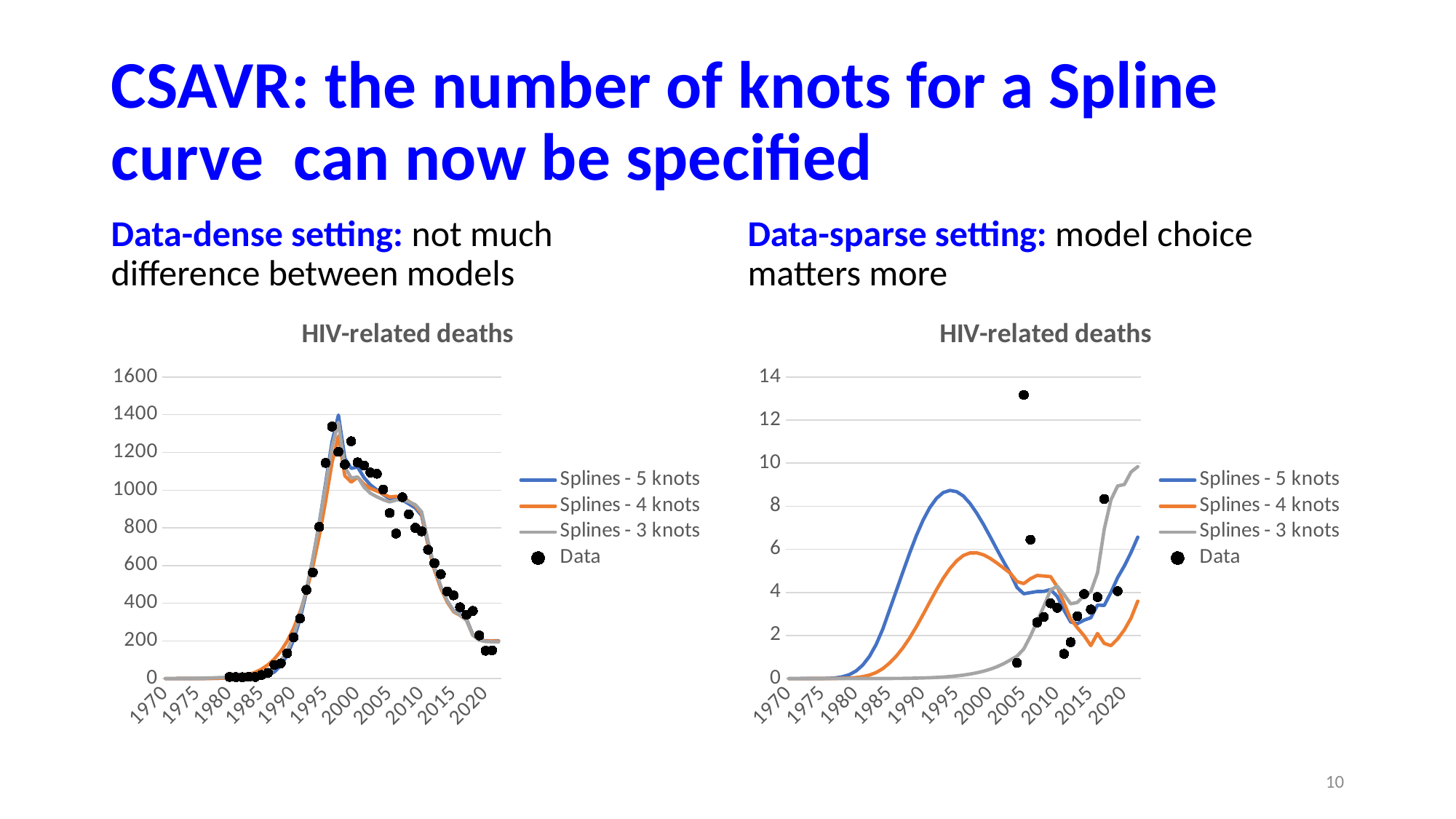
In the left chart, is the peak value of the 'Splines - 5 knots' line greater or less than 1200? greater In the left chart, do the spline curves rise or fall between 2010 and 2020? fall In the left chart, is the value of the 'Splines - 4 knots' line in 1990 greater or less than 400? less In the right chart, is the highest 'Data' point greater or less than 12? greater In the right chart, does the 'Splines - 3 knots' line rise or fall between 2010 and 2020? rise How many entries does the legend of the left chart list? 4 What type of chart is the left chart titled 'HIV-related deaths'? line chart What is the highest value shown on the y axis of the right chart? 14 In the right chart, which line reaches a higher peak around 1995, 'Splines - 5 knots' or 'Splines - 4 knots'? Splines - 5 knots How many year labels are shown on the x axis of the right chart? 11